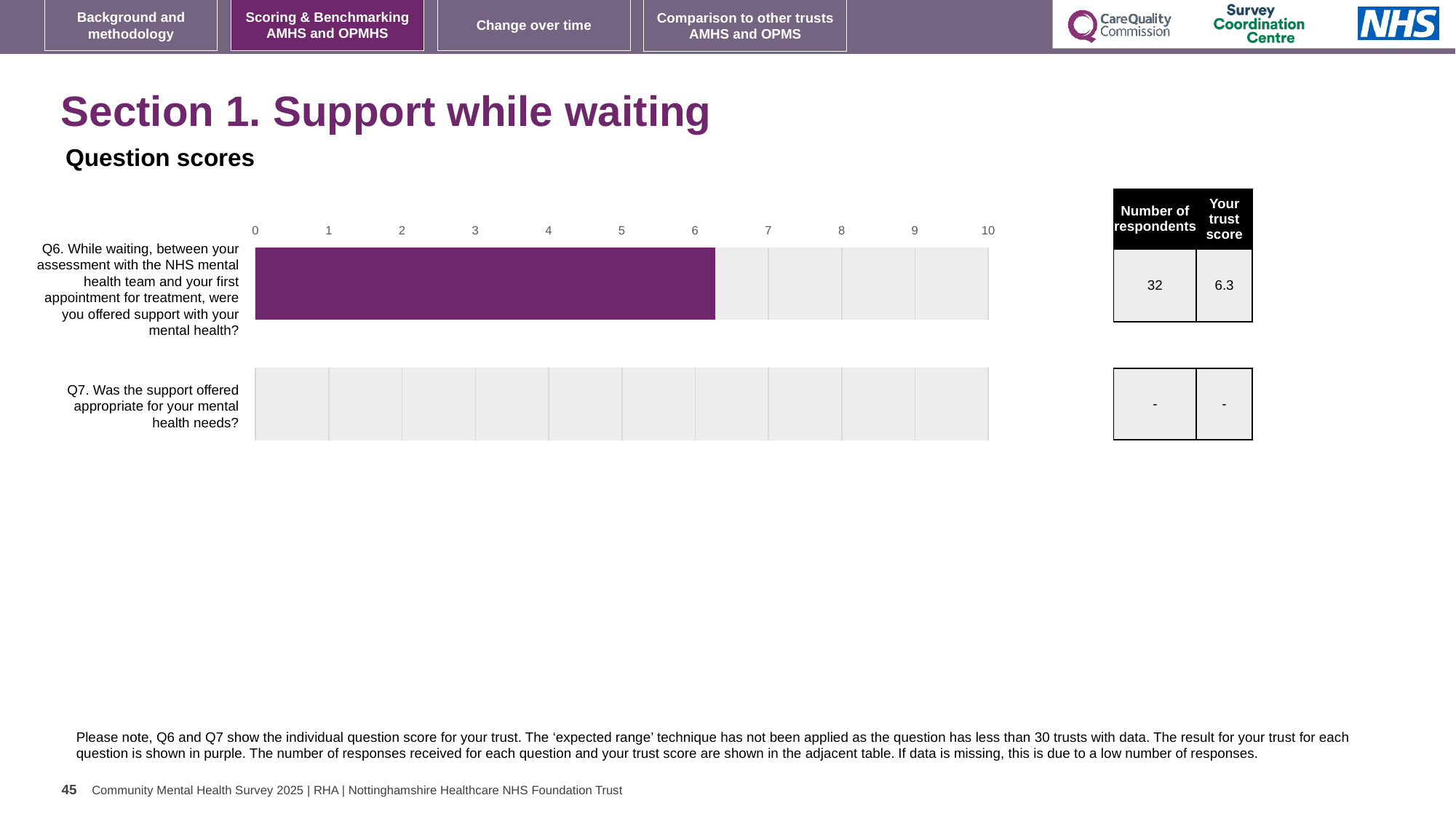
What colour is the bar showing the trust's result for Q6? purple What is the highest value shown on the chart's axis? 10 How many questions are listed on the chart? 2 What is shown in the table for the number of respondents and trust score for Q7? - What is the trust score for Q6 shown in the table next to the chart? 6.3 Is the bar for Q6 greater or less than 7 on the axis? less Is the bar for Q6 greater or less than 5 on the axis? greater How many respondents answered Q6 according to the table? 32 What kind of chart is used to show the question scores on this slide? bar chart Which question has a purple bar plotted on the chart? Q6